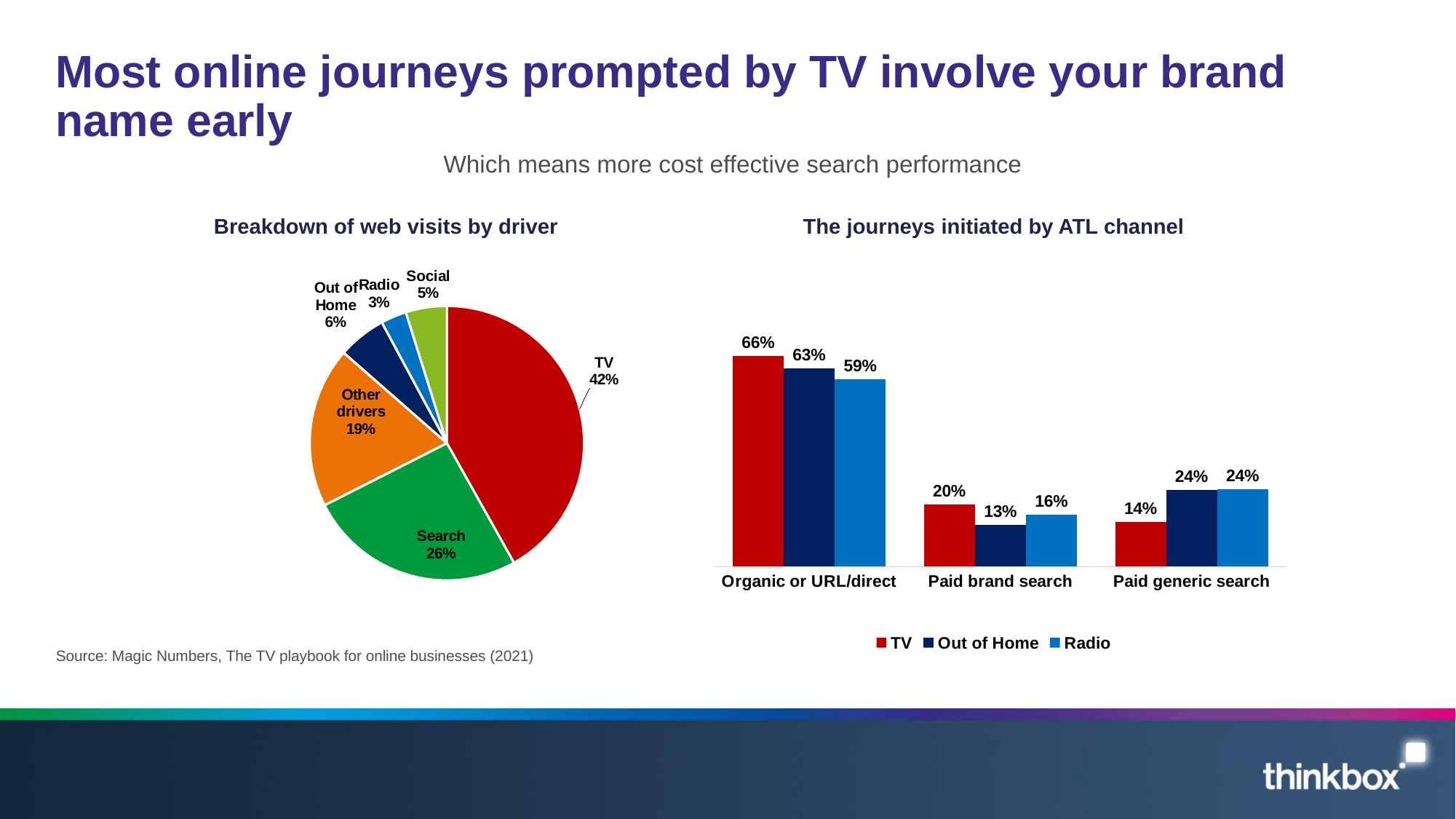
In 'The journeys initiated by ATL channel' chart, what is the TV value for Organic or URL/direct? 66% In the 'Breakdown of web visits by driver' chart, which driver has the largest share? TV In 'The journeys initiated by ATL channel' chart, what is the Out of Home value for Paid brand search? 13% In the 'Breakdown of web visits by driver' chart, how many slices does the pie have? 6 What kind of chart is 'The journeys initiated by ATL channel'? Bar chart In 'The journeys initiated by ATL channel' chart, which is larger for Paid generic search: TV or Radio? Radio What kind of chart is 'Breakdown of web visits by driver'? Pie chart In the 'Breakdown of web visits by driver' chart, what share of web visits is driven by TV? 42% In the 'Breakdown of web visits by driver' chart, what share of web visits is driven by Search? 26% In 'The journeys initiated by ATL channel' chart, what is the difference between the TV and Radio values for Organic or URL/direct? 7% How many series does the legend of 'The journeys initiated by ATL channel' chart list? 3 In the 'Breakdown of web visits by driver' chart, which driver has the smallest share? Radio